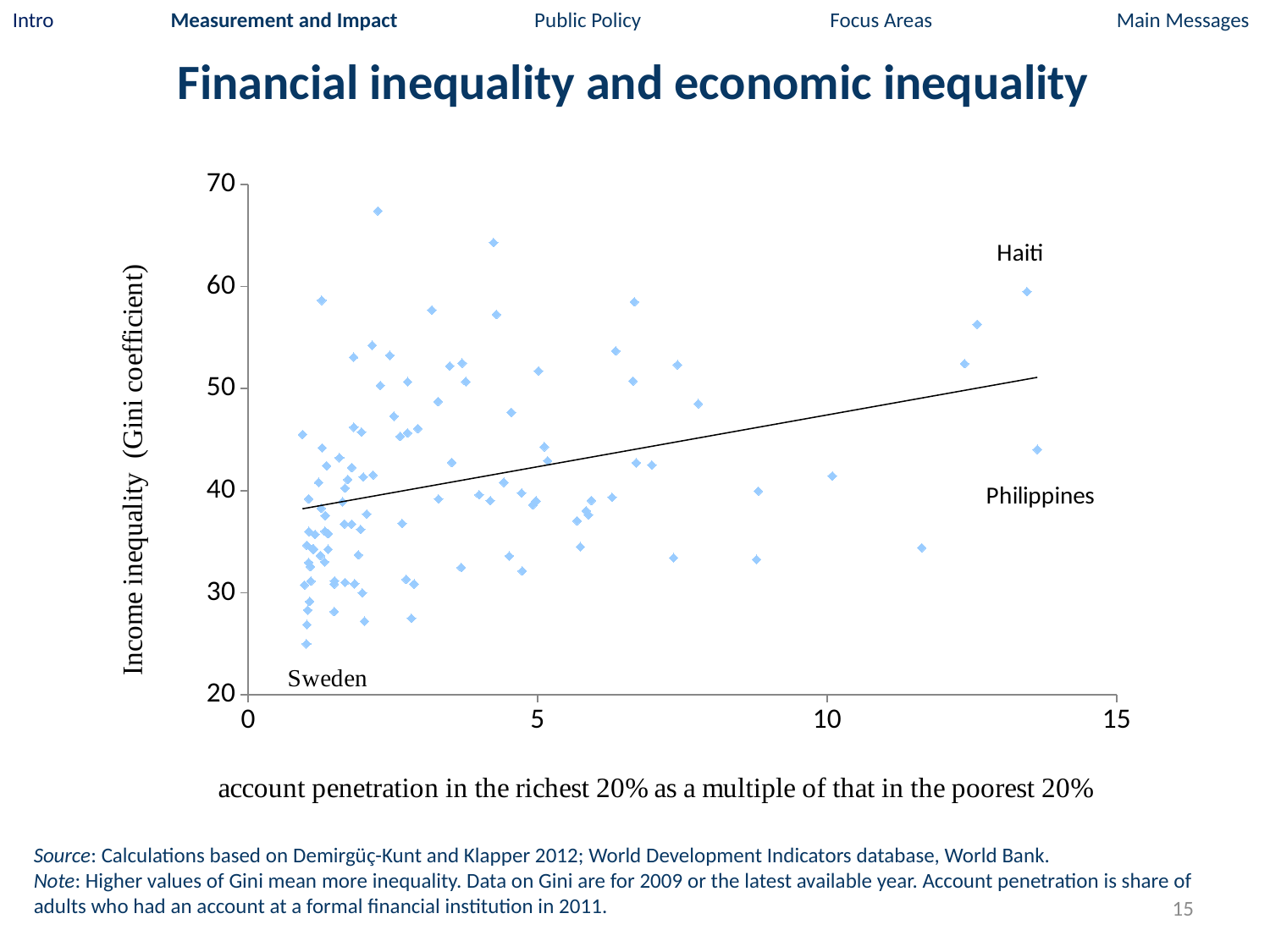
Is the account penetration ratio for Sweden greater or less than 5? less What is the title of the chart? Financial inequality and economic inequality Is the Gini coefficient for the Philippines greater or less than 50? less Is the account penetration ratio for Haiti greater or less than 10? greater What is the highest value shown on the vertical axis? 70 Which labelled country has a lower Gini coefficient, Sweden or Haiti? Sweden Which labelled country has a higher Gini coefficient, Haiti or the Philippines? Haiti Does the fitted trend line rise or fall as account penetration ratio increases along the x axis? rises What kind of chart is shown on the slide? scatter plot What is the label of the vertical axis? Income inequality (Gini coefficient)